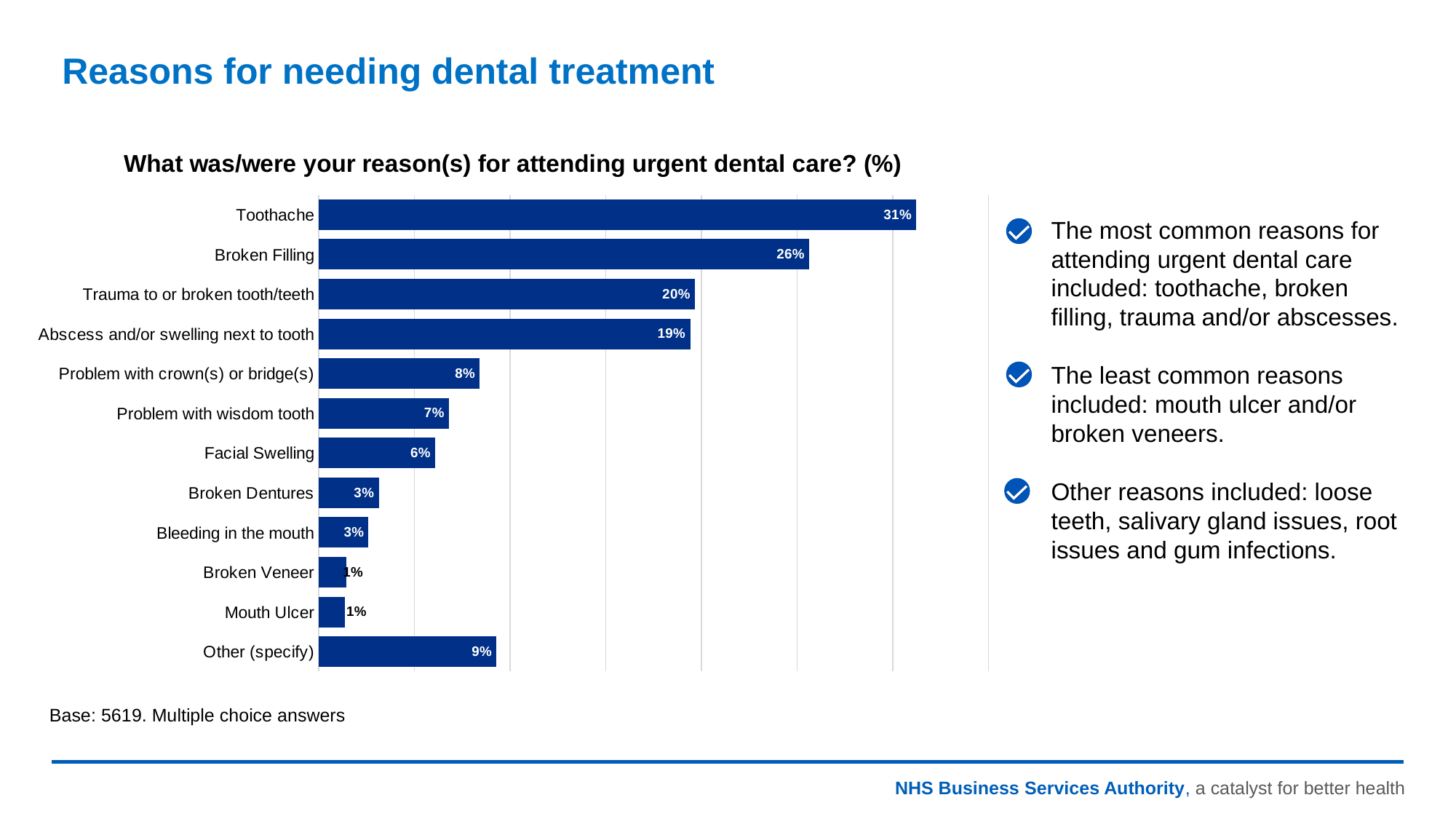
What type of chart is used on this slide? Bar chart What is the title of the chart? What was/were your reason(s) for attending urgent dental care? (%) Which is larger, Facial Swelling or Problem with wisdom tooth? Problem with wisdom tooth Which is larger, Other (specify) or Problem with crown(s) or bridge(s)? Other (specify) How many reason categories are shown in the chart? 12 What is the difference between Trauma to or broken tooth/teeth and Problem with crown(s) or bridge(s)? 12 Which reason has the highest percentage? Toothache What percentage of respondents gave Toothache as a reason for attending urgent dental care? 31% What is the difference in percentage points between Toothache and Broken Filling? 5 What is the value for Other (specify)? 9% What percentage is shown for Abscess and/or swelling next to tooth? 19% What is the value shown for Broken Filling? 26%